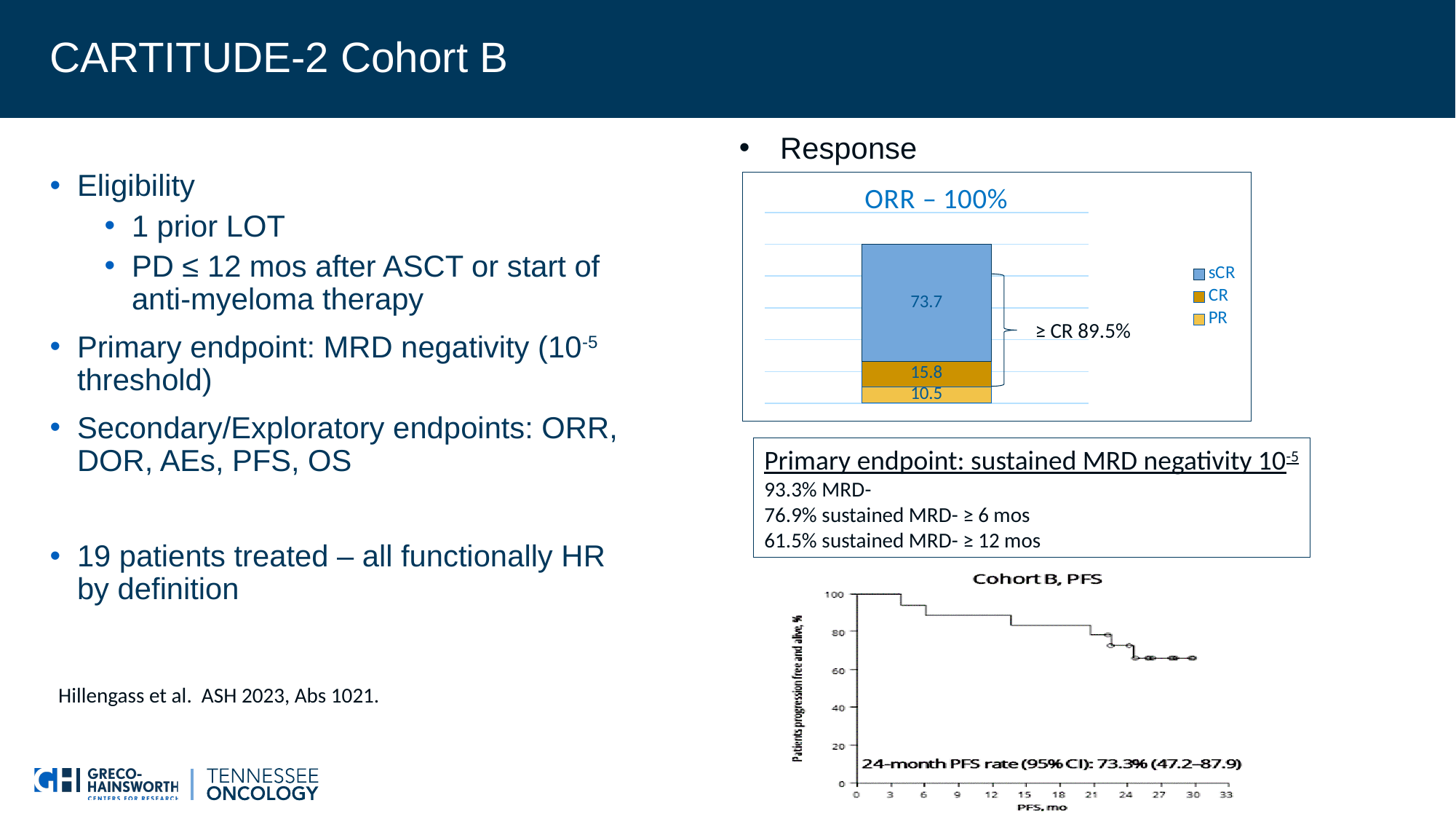
In the ORR – 100% chart, which response category has the smallest segment? PR In the ORR – 100% chart, which response category has the largest segment? sCR What kind of chart is the ORR – 100% chart? Stacked bar chart In the Cohort B, PFS chart, what is the 24-month PFS rate shown? 73.3% In the ORR – 100% chart, how many series does the legend list? 3 In the ORR – 100% chart, what is the value of the PR segment? 10.5 In the ORR – 100% chart, which is larger, the CR segment or the PR segment? CR In the ORR – 100% chart, what is the difference between the sCR and CR values? 57.9 In the ORR – 100% chart, what is the total of the stacked bar? 100 In the ORR – 100% chart, what is the value of the CR segment? 15.8 In the ORR – 100% chart, what is the value of the sCR segment? 73.7 In the Cohort B, PFS chart, does the curve rise or fall as PFS months increase? Fall